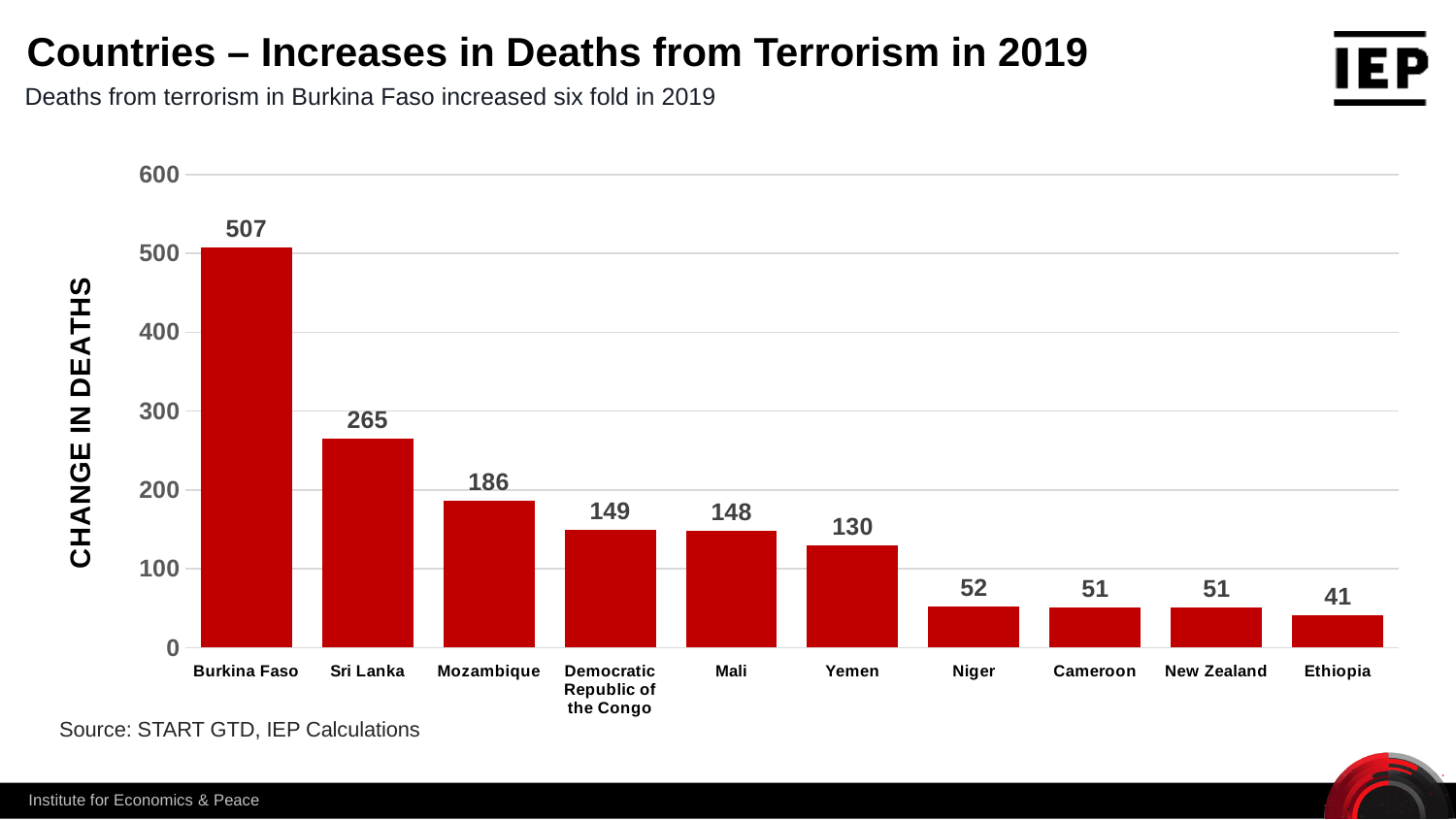
Which country has the highest change in deaths? Burkina Faso What kind of chart is shown on the slide? Bar chart What is the difference in change in deaths between Mozambique and Niger? 134 How many countries are shown in the chart? 10 What is the change in deaths for Mozambique? 186 Which has a larger change in deaths, Sri Lanka or Mali? Sri Lanka Is the value for Sri Lanka greater or less than 200? greater What is the label of the vertical axis? CHANGE IN DEATHS What is the difference in change in deaths between Burkina Faso and Sri Lanka? 242 What is the change in deaths for Burkina Faso? 507 Which country has the lowest change in deaths? Ethiopia What is the change in deaths for Yemen? 130